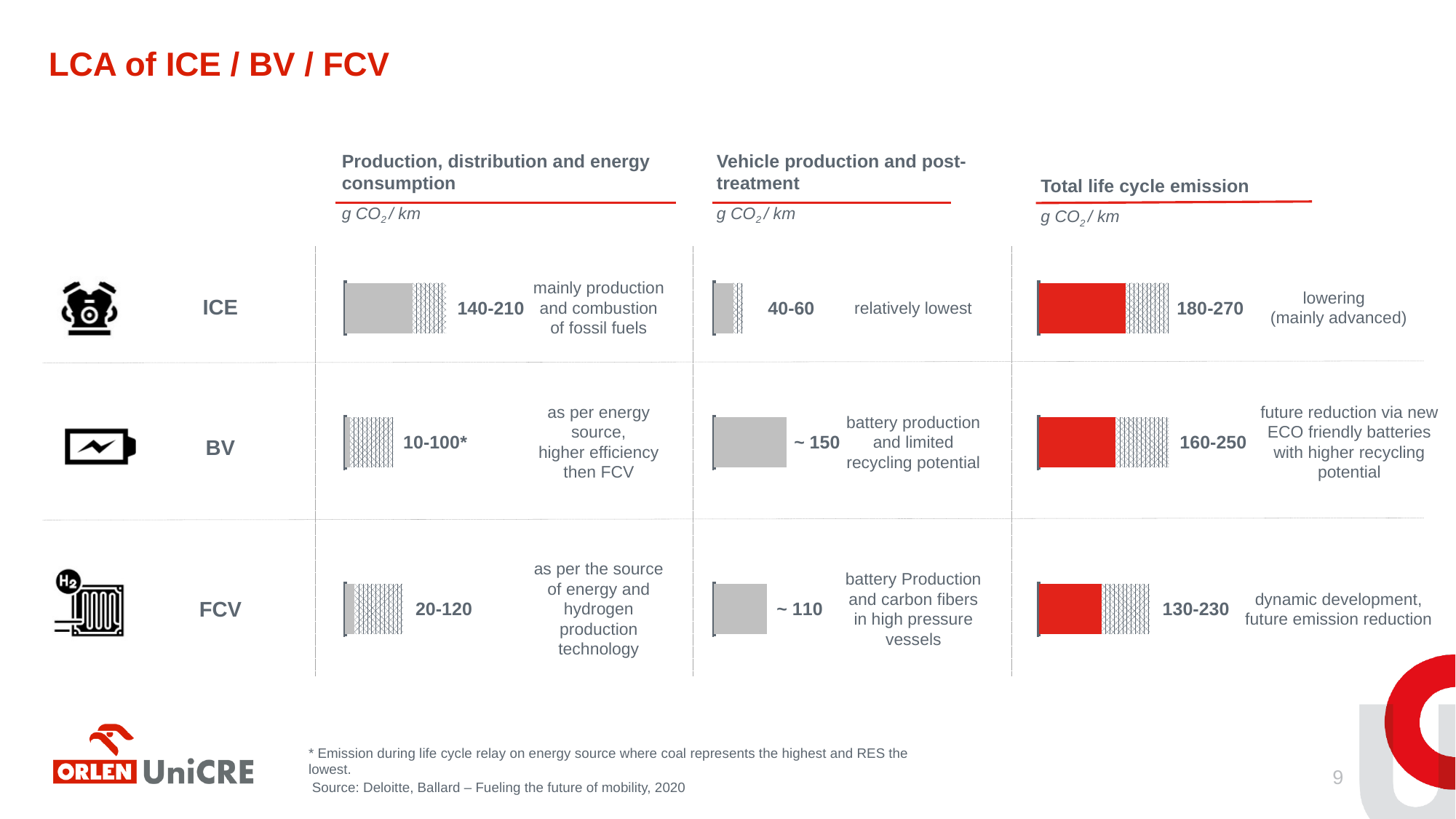
Which has the higher vehicle production and post-treatment emission, BV or FCV? BV What is the vehicle production and post-treatment emission value shown for FCV? ~ 110 What is the production, distribution and energy consumption emission range shown for FCV? 20-120 How many vehicle types are compared on the slide? 3 What is the total life cycle emission range shown for FCV? 130-230 What is the total life cycle emission range shown for ICE? 180-270 Which vehicle type has the highest total life cycle emission? ICE In what unit are the emission values given? g CO2 / km Which vehicle type has the lowest vehicle production and post-treatment emission? ICE What is the vehicle production and post-treatment emission range shown for ICE? 40-60 What is the production, distribution and energy consumption emission range shown for BV? 10-100* What kind of chart is used to show the emission values? Bar chart